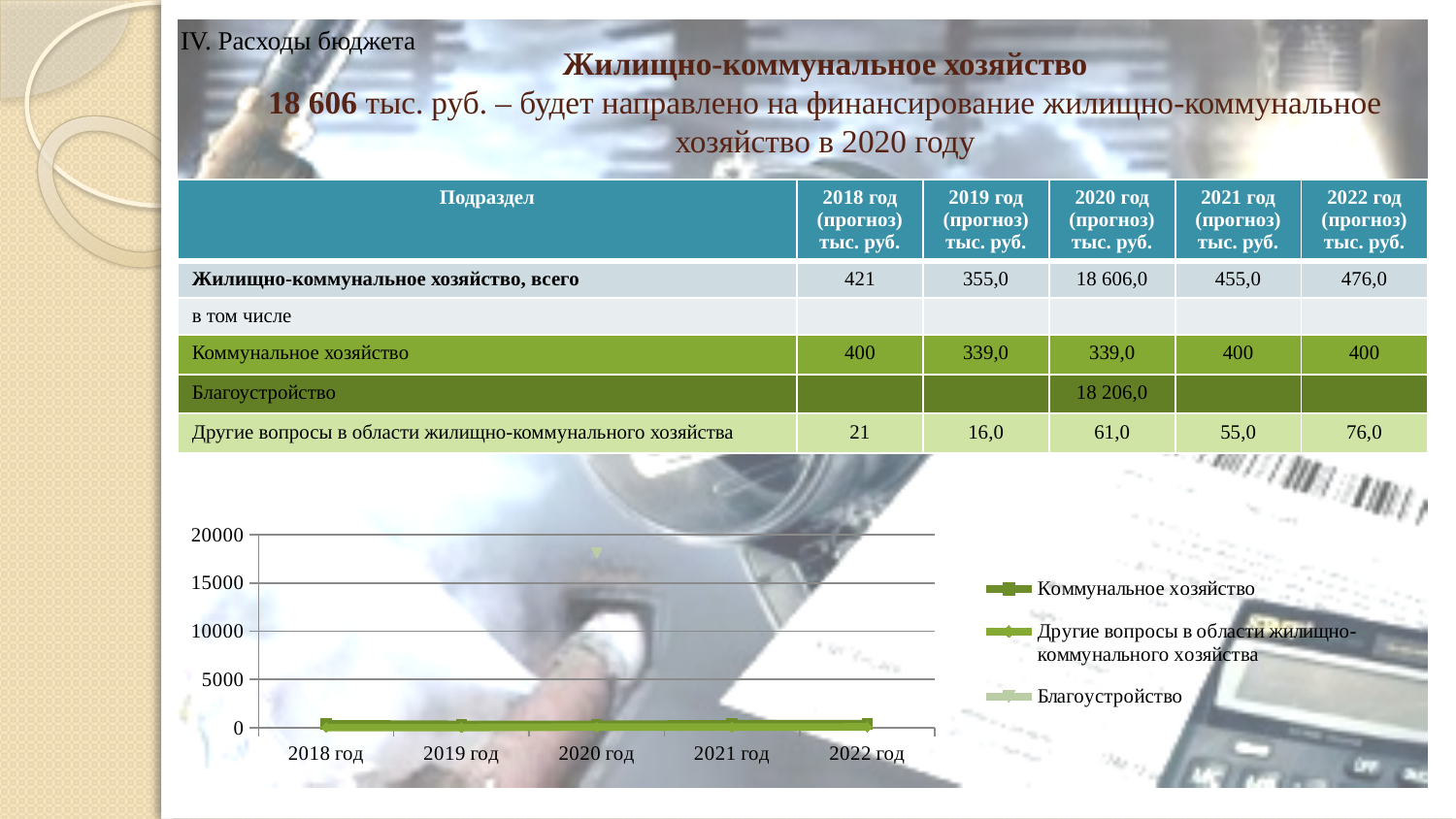
How many series does the legend of the chart list? 3 In which year does the Благоустройство series reach its highest point on the chart? 2020 год What is the highest tick value shown on the y axis of the chart? 20000 Which year is the last category on the x axis of the chart? 2022 год Is the value for Другие вопросы в области жилищно-коммунального хозяйства in 2022 год greater or less than 5000? less In 2020 год, which is larger on the chart: Благоустройство or Коммунальное хозяйство? Благоустройство Is the value for Коммунальное хозяйство in 2018 год greater or less than 5000? less Which series has the highest single point on the chart? Благоустройство What kind of chart is shown at the bottom of the slide? line chart How many years are shown along the x axis of the chart? 5 Is the value for Благоустройство in 2020 год greater or less than 15000? greater Which year is the first category on the x axis of the chart? 2018 год